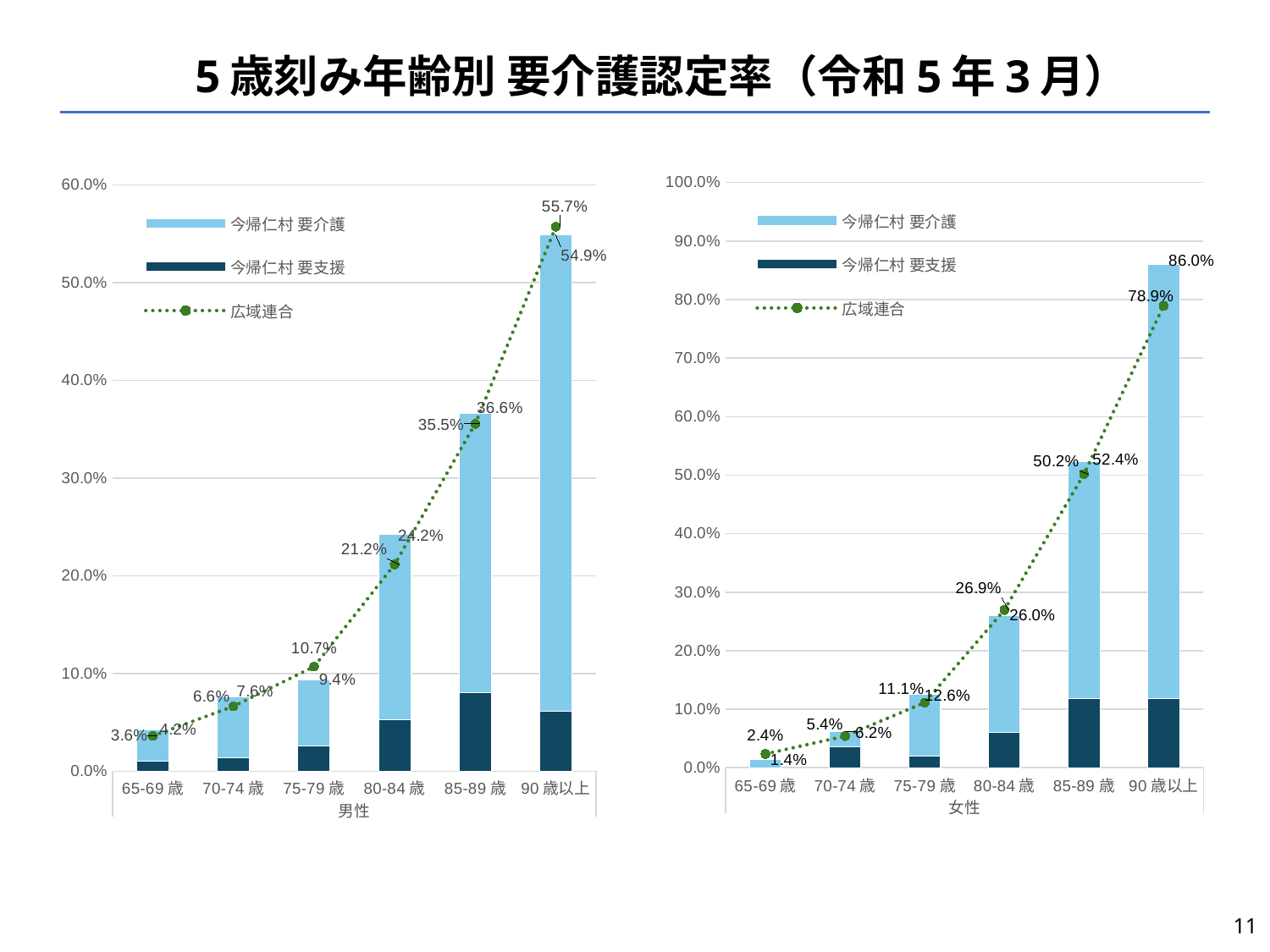
What kind of chart is the left chart (男性)? bar chart with a line In the left chart (男性), what is the 広域連合 value for 90歳以上? 55.7% How many series does the legend of the right chart (女性) list? 3 In the left chart (男性), which age category has the lowest stacked bar? 65-69歳 In the right chart (女性), what is the total of the stacked bar for 90歳以上? 86.0% In the left chart (男性), what is the total of the stacked bar for 80-84歳? 24.2% In the left chart (男性), is the 今帰仁村 要支援 value for 90歳以上 greater or less than 10.0%? less In the right chart (女性), what is the 広域連合 value for 90歳以上? 78.9% In the right chart (女性), is the 広域連合 value for 85-89歳 larger or smaller than the 広域連合 value for 80-84歳? larger In the right chart (女性), which age category has the highest stacked bar? 90歳以上 In the right chart (女性), do the 広域連合 values rise or fall as age increases along the x axis? rise How many age categories are shown on the x axis of the left chart (男性)? 6